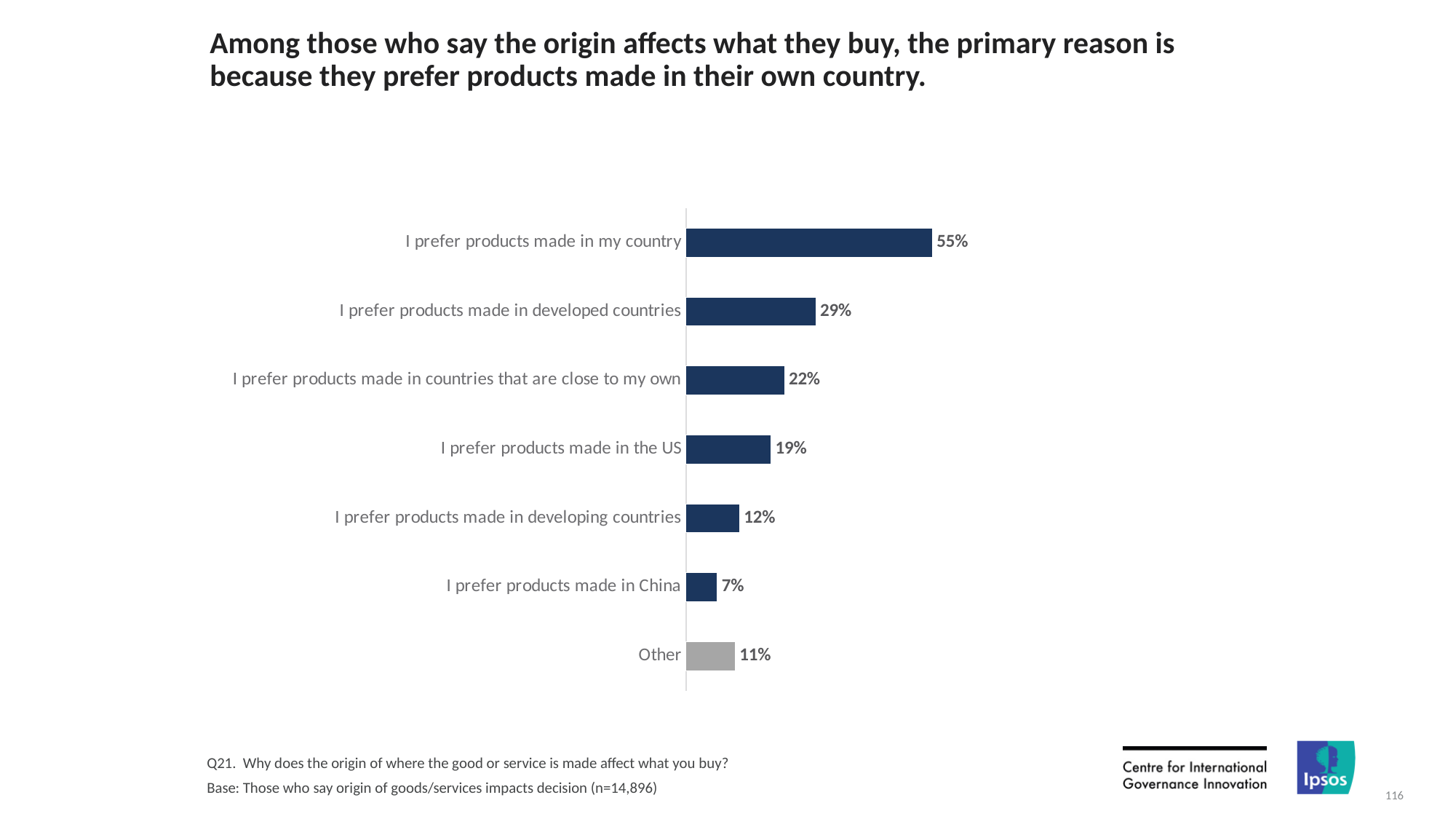
What is the value for "I prefer products made in developed countries"? 29% What type of chart is shown on the slide? Bar chart What is the value shown for "Other"? 11% Which is larger: the value for "I prefer products made in developing countries" or the value for "Other"? I prefer products made in developing countries Which bar is shown in a different colour (grey) from the others? Other Which reason has the highest percentage? I prefer products made in my country What percentage of respondents say they prefer products made in their own country? 55% What is the difference between "I prefer products made in my country" and "I prefer products made in developed countries"? 26 percentage points What percentage say they prefer products made in China? 7% What is the difference between "I prefer products made in countries that are close to my own" and "I prefer products made in the US"? 3 percentage points Which reason has the lowest percentage? I prefer products made in China How many categories are shown in the chart? 7